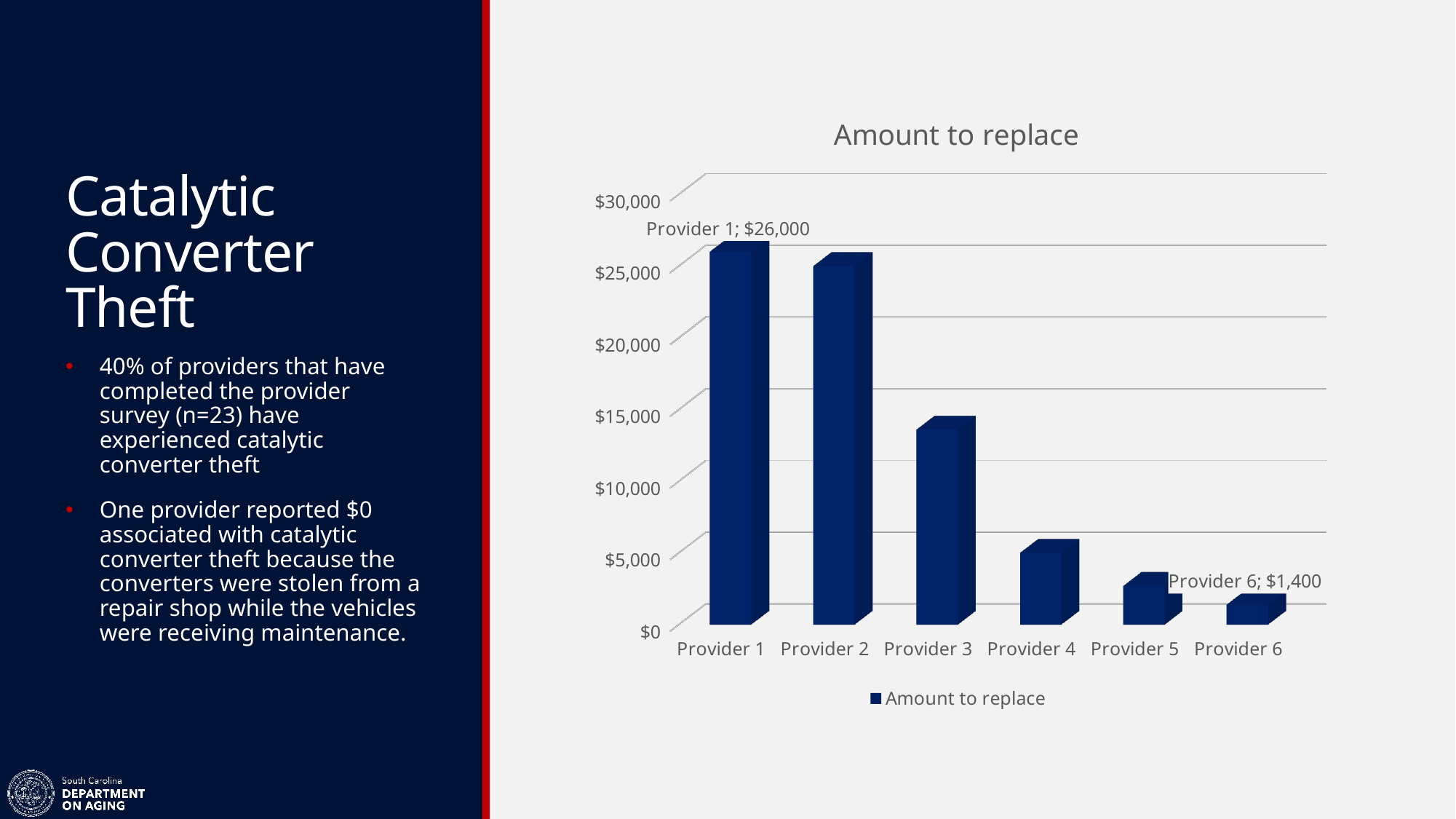
Which provider has the highest amount to replace? Provider 1 Is the value for Provider 2 greater or less than $20,000? greater How many series does the legend list? 1 How many providers are shown in the chart? 6 Which has a larger amount to replace, Provider 3 or Provider 4? Provider 3 What kind of chart is shown on the slide? Bar chart Is the value for Provider 4 greater or less than $10,000? less Is the value for Provider 3 greater or less than $15,000? less What is the value for Provider 1 in the Amount to replace chart? $26,000 What is the difference between the amount to replace for Provider 1 and Provider 6? $24,600 Which provider has the lowest amount to replace? Provider 6 What is the value for Provider 6 in the Amount to replace chart? $1,400